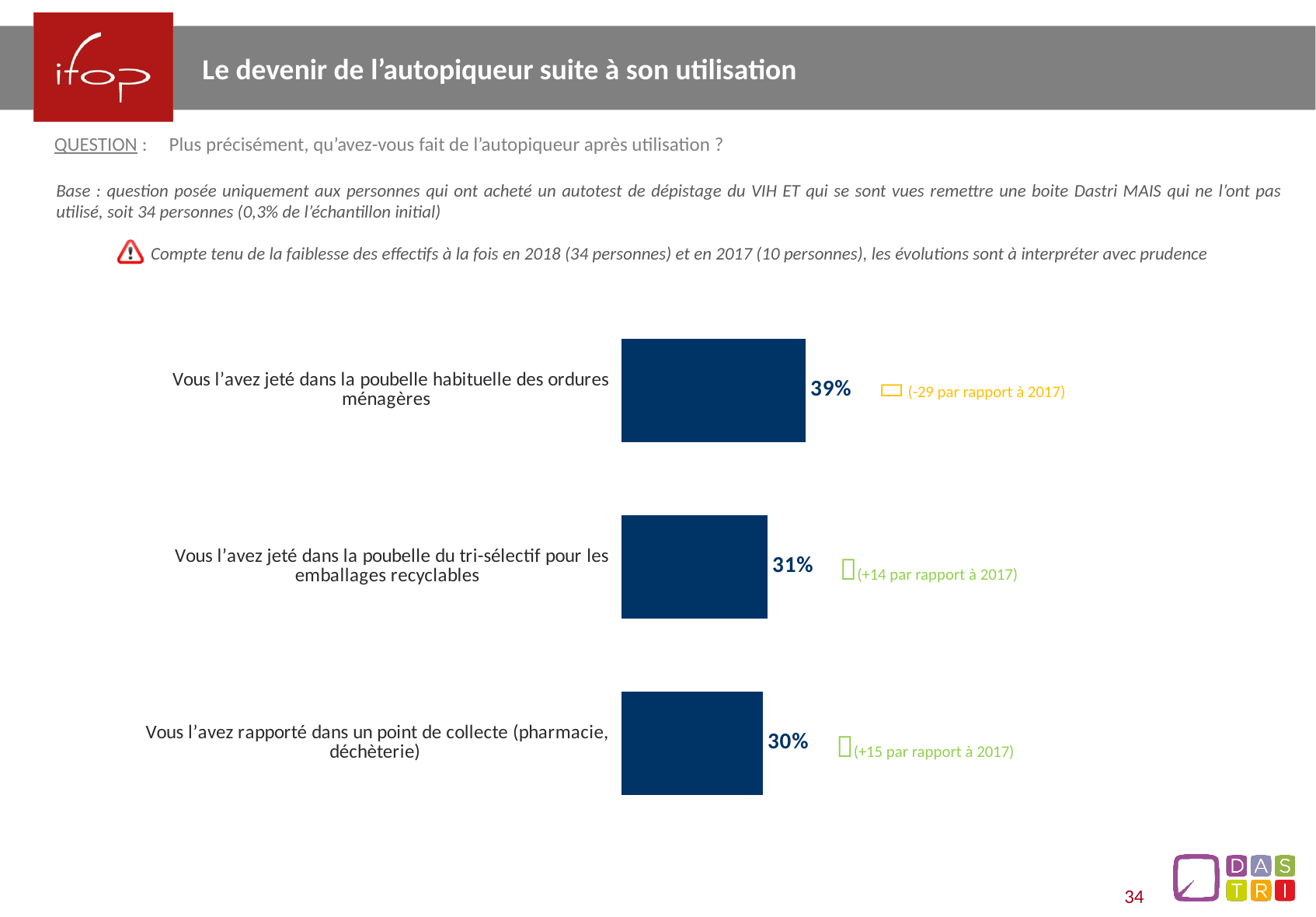
What is the change compared to 2017 shown next to the household waste bin category? -29 par rapport à 2017 Which category has the lowest percentage? Vous l'avez rapporté dans un point de collecte (pharmacie, déchèterie) What percentage of respondents threw the lancing device in the usual household waste bin ("poubelle habituelle des ordures ménagères")? 39% How many categories are shown in the chart? 3 What type of chart is shown on the slide? Bar chart What percentage of respondents brought the lancing device back to a collection point ("point de collecte")? 30% Which category has the highest percentage? Vous l'avez jeté dans la poubelle habituelle des ordures ménagères What is the change compared to 2017 shown next to the collection point category? +15 par rapport à 2017 What percentage of respondents threw the lancing device in the recycling bin ("poubelle du tri-sélectif pour les emballages recyclables")? 31% Which is larger: the percentage for the recycling bin or the percentage for the collection point? Recycling bin (31%) What is the difference in percentage points between the household waste bin category and the recycling bin category? 8 What is the difference in percentage points between the household waste bin category and the collection point category? 9